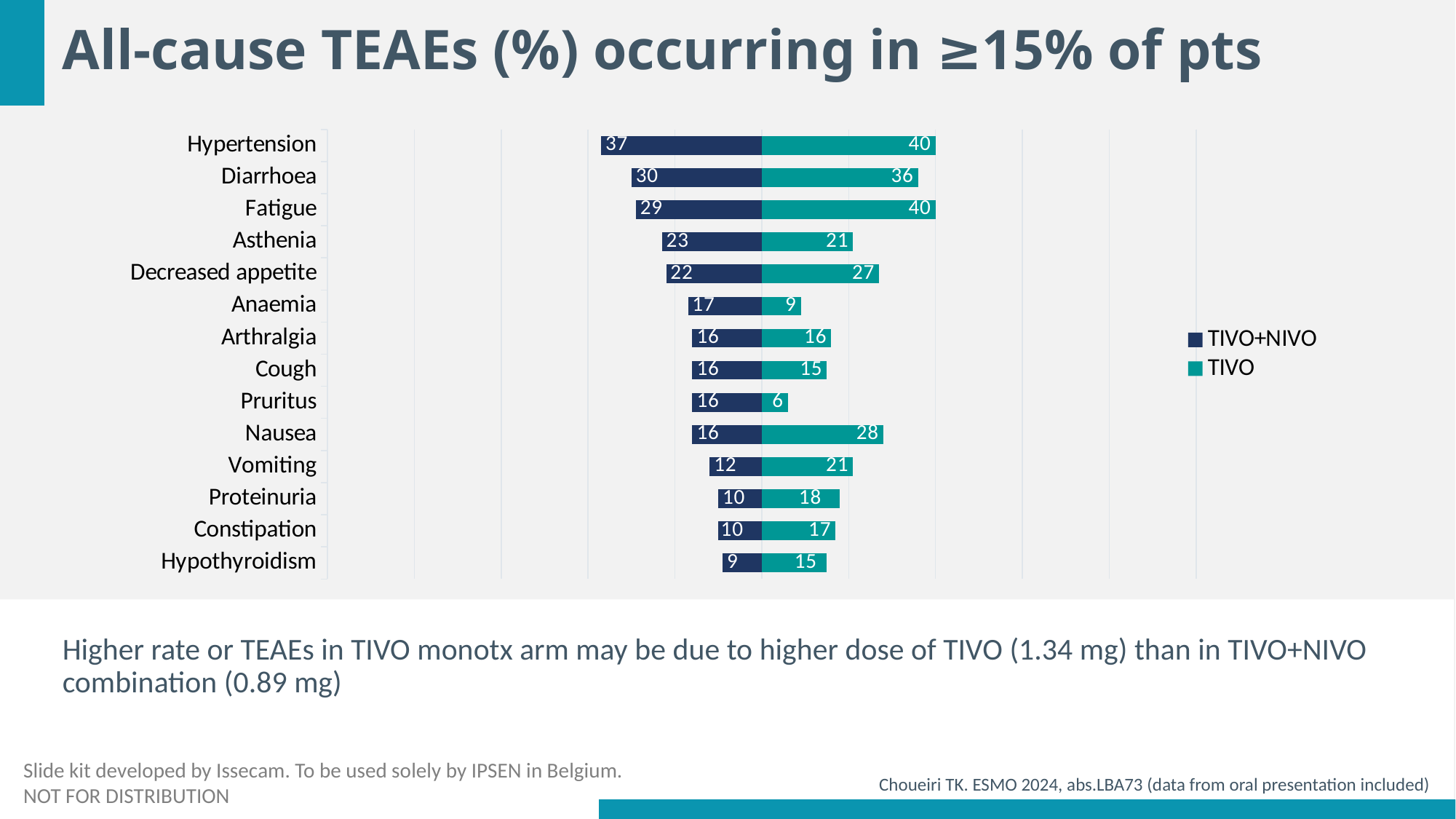
Which is larger for Anaemia, the TIVO+NIVO value or the TIVO value? TIVO+NIVO Which category has the lowest TIVO value? Pruritus Which category has the highest TIVO+NIVO value? Hypertension What is the TIVO+NIVO value for Hypothyroidism? 9 Which series is shown in dark navy in the legend? TIVO+NIVO What is the TIVO+NIVO value for Hypertension? 37 What is the TIVO value for Pruritus? 6 What kind of chart is shown on the slide? Bar chart What is the difference between the TIVO and TIVO+NIVO values for Fatigue? 11 How many series does the legend list? 2 How many categories (TEAEs) are shown in the chart? 14 What is the TIVO value for Nausea? 28